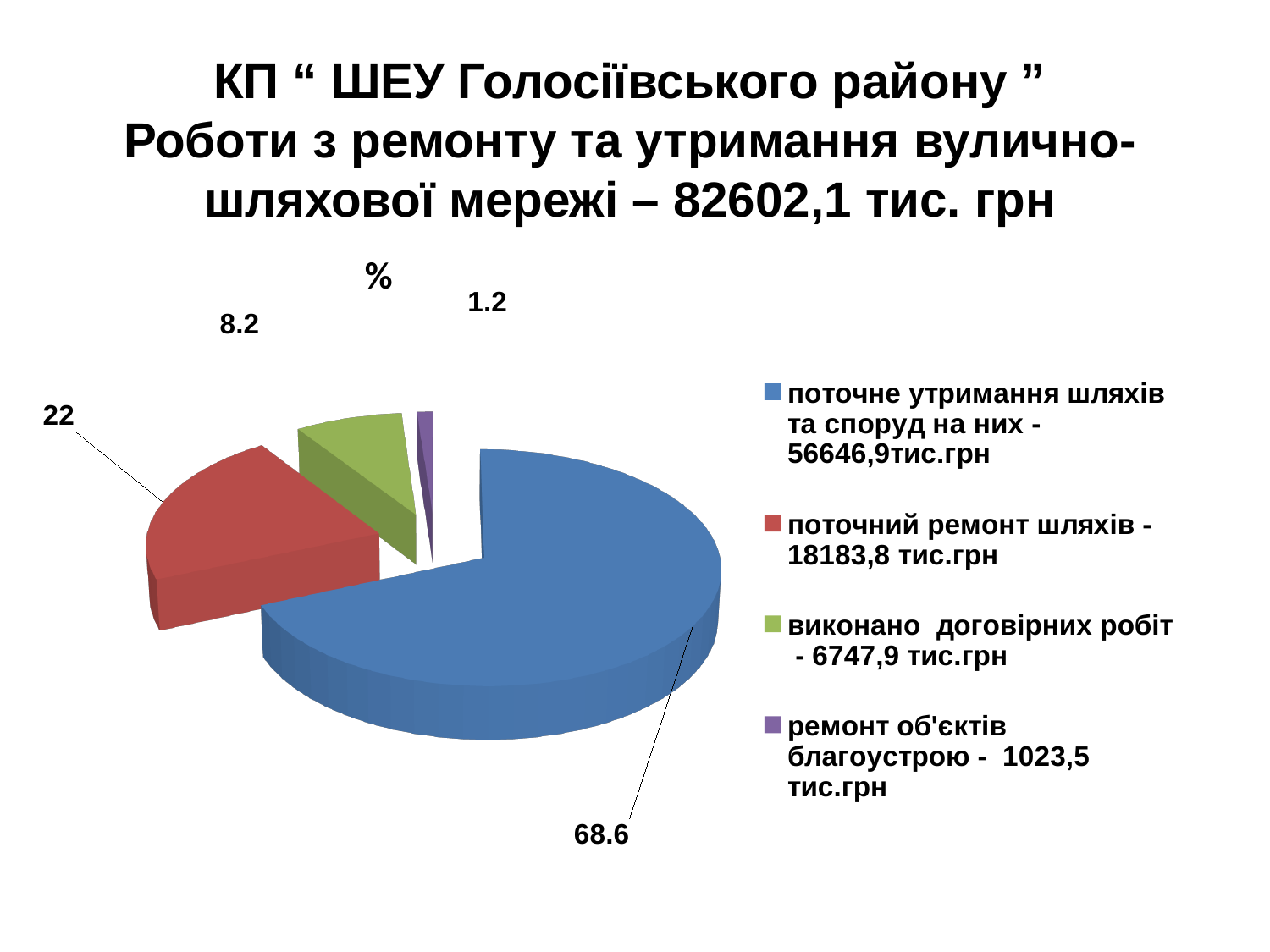
Which colour is the slice for 'поточний ремонт шляхів - 18183,8 тис.грн'? red What percentage is shown for the slice 'виконано договірних робіт - 6747,9 тис.грн'? 8.2 What is the difference between the percentages for 'поточний ремонт шляхів' and 'виконано договірних робіт'? 13.8 How many entries does the legend list? 4 What is the chart's title? % What kind of chart is shown on the slide? pie chart How many slices does the pie chart have? 4 What percentage is shown for the slice 'ремонт об'єктів благоустрою - 1023,5 тис.грн'? 1.2 What percentage is shown for the slice 'поточний ремонт шляхів - 18183,8 тис.грн'? 22 What percentage is shown for the slice 'поточне утримання шляхів та споруд на них - 56646,9тис.грн'? 68.6 Which slice is the largest? поточне утримання шляхів та споруд на них - 56646,9тис.грн Which slice is the smallest? ремонт об'єктів благоустрою - 1023,5 тис.грн